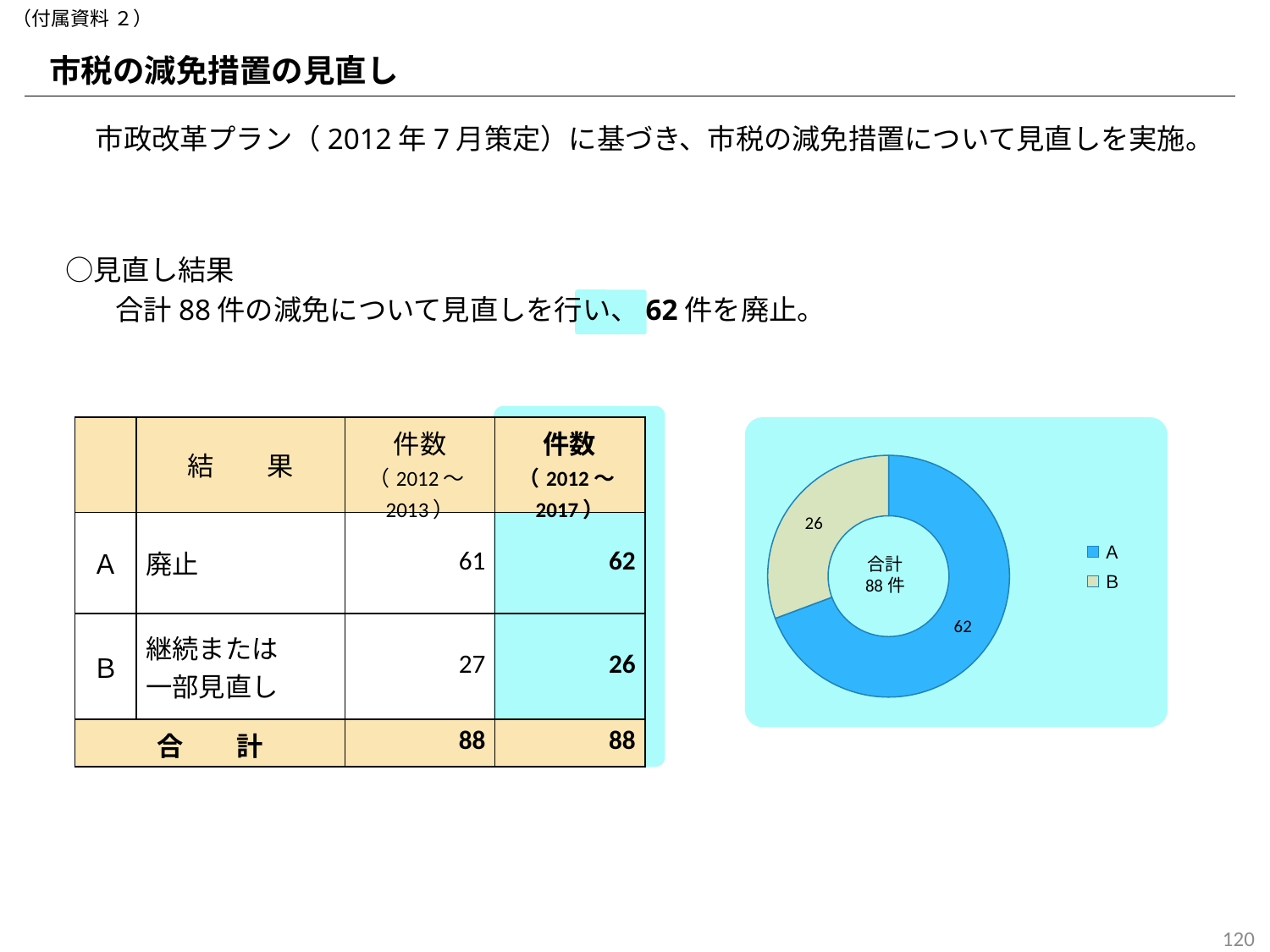
Which category has the largest slice in the donut chart? A What is the difference between the values for A and B in the donut chart? 36 Which category has the smallest slice in the donut chart? B What is the value for B in the donut chart? 26 What is the value for A in the donut chart? 62 What kind of chart is shown on the slide? Donut chart What colour is the slice for A in the donut chart? Blue Which is larger in the donut chart, A or B? A What total is printed in the centre of the donut chart? 合計 88 件 How many entries does the legend of the donut chart list? 2 What is the total of the two slices in the donut chart? 88 How many categories does the donut chart show? 2